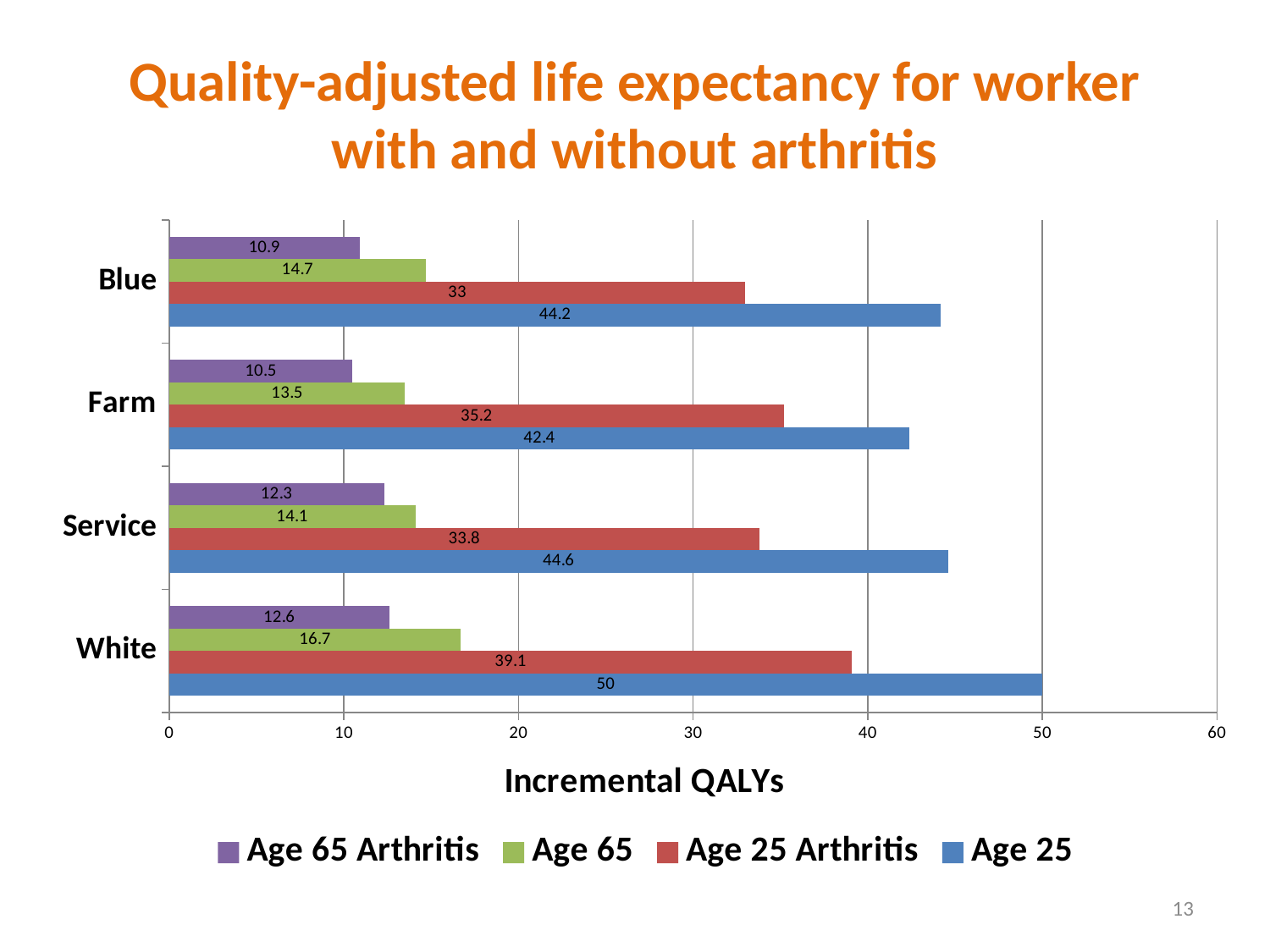
What is the Age 65 Arthritis value for Farm? 10.5 Which is larger, the Age 25 Arthritis value for Farm or for Blue? Farm What is the difference between the Age 25 and Age 25 Arthritis values for White? 10.9 Which category has the lowest Age 65 Arthritis value? Farm How many series does the legend list? 4 What is the Age 25 value for White? 50 What is the Age 65 value for Blue? 14.7 Which category has the highest Age 25 value? White Is the Age 25 value for Farm greater or less than 40? greater What kind of chart is shown on the slide? bar chart What is the Age 25 Arthritis value for Service? 33.8 How many categories are shown on the y axis? 4